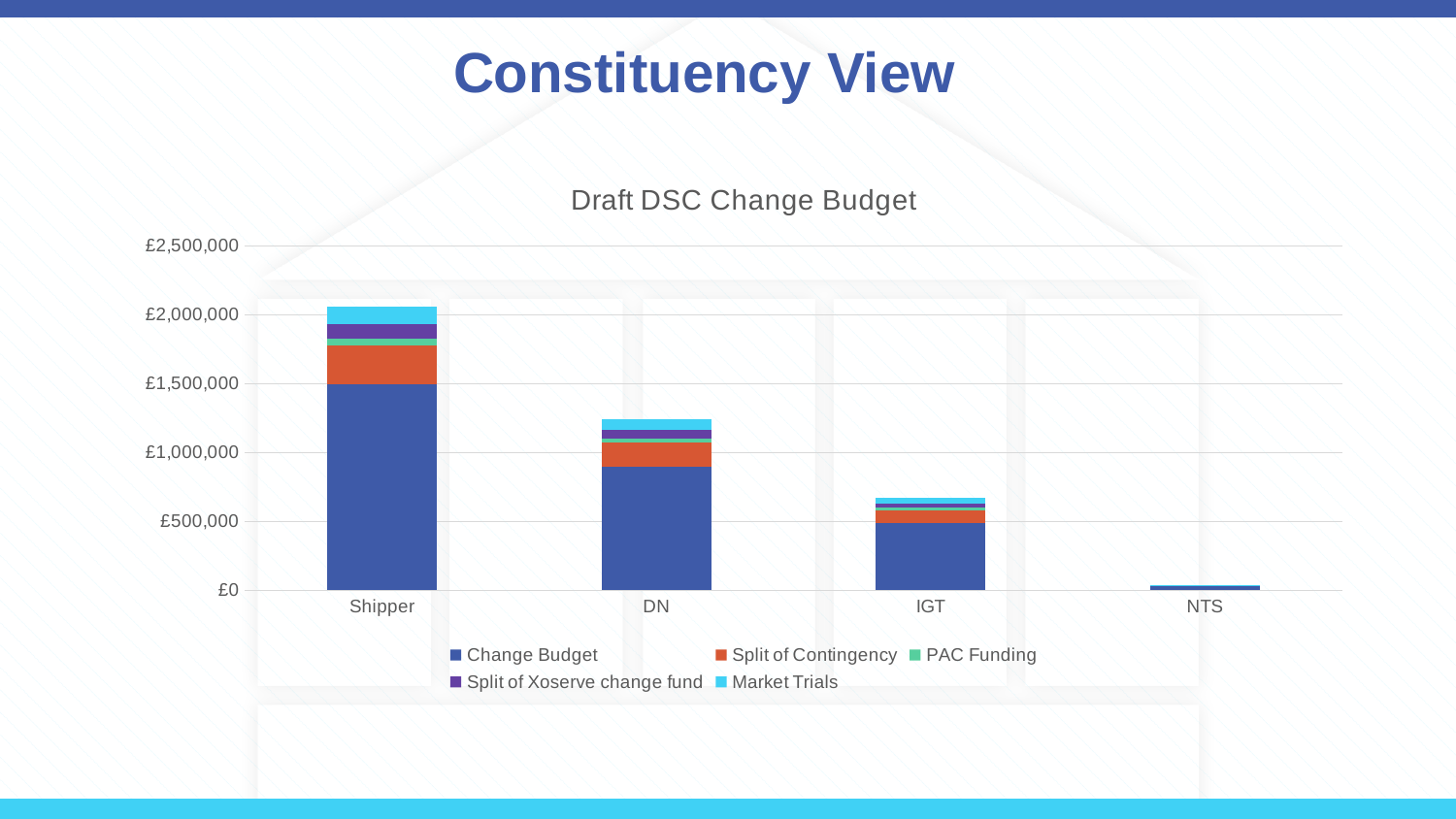
Which category has the highest total bar? Shipper What is the title of the chart? Draft DSC Change Budget Which category has the lowest total bar? NTS Is the total bar for IGT greater or less than £500,000? greater Which has the larger total bar, DN or IGT? DN How many categories are shown on the x axis? 4 How many series does the legend list? 5 Do the total bar heights rise or fall moving from Shipper to NTS along the x axis? fall Is the total bar for NTS greater or less than £500,000? less What kind of chart is shown on the slide? Stacked bar chart Is the total bar for Shipper greater or less than £1,500,000? greater